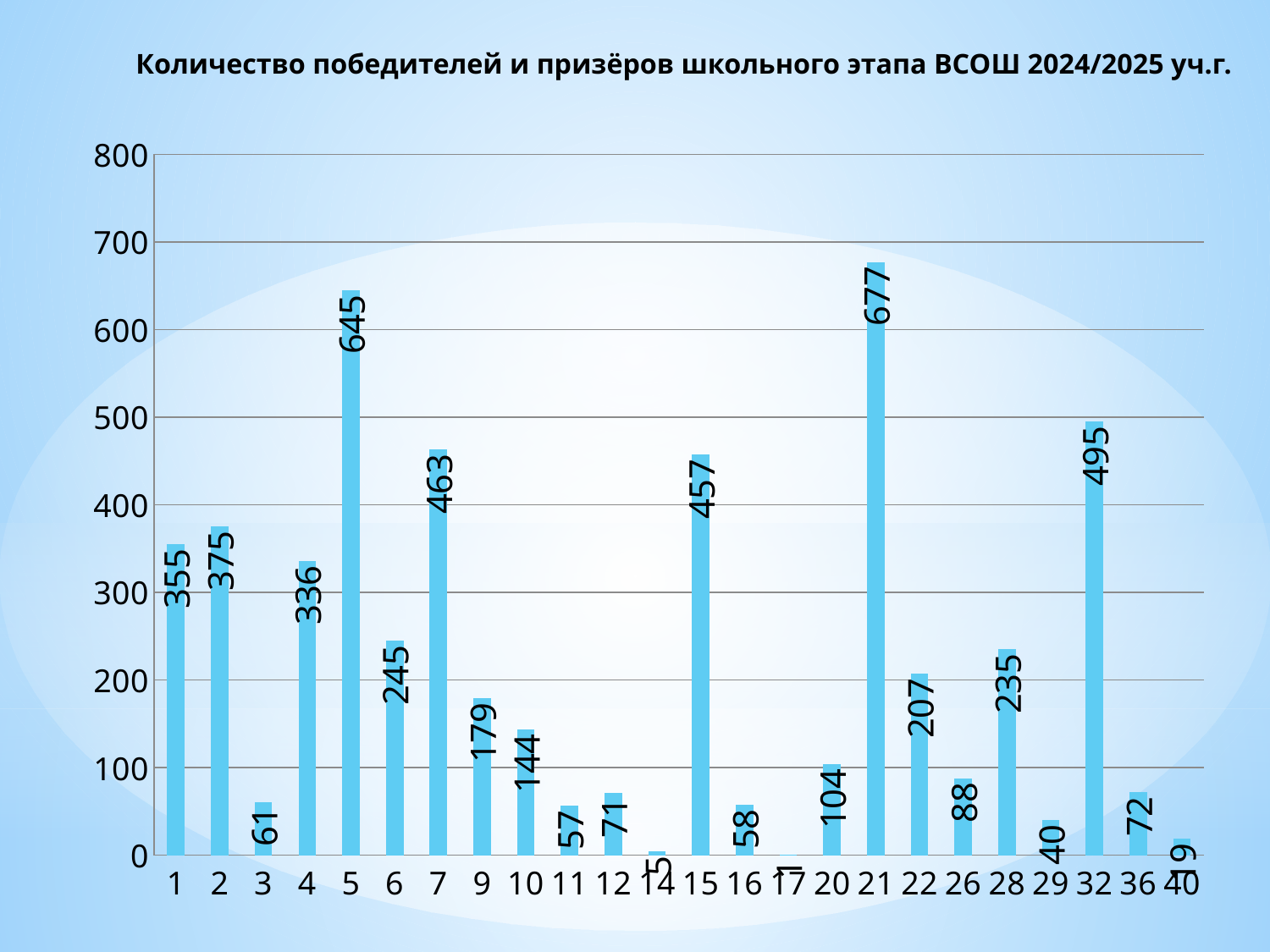
Which category has the highest value? 21 What is the title of the chart? Количество победителей и призёров школьного этапа ВСОШ 2024/2025 уч.г. Is the value for category 32 greater or less than 400? greater What kind of chart is shown on the slide? bar chart What is the value for category 5? 645 How many categories are shown on the x axis? 24 What is the difference between the values for category 2 and category 1? 20 What is the value for category 28? 235 Which has a larger value, category 7 or category 15? 7 Which category has the lowest value? 17 What is the difference between the values for category 21 and category 5? 32 What is the value for category 21? 677